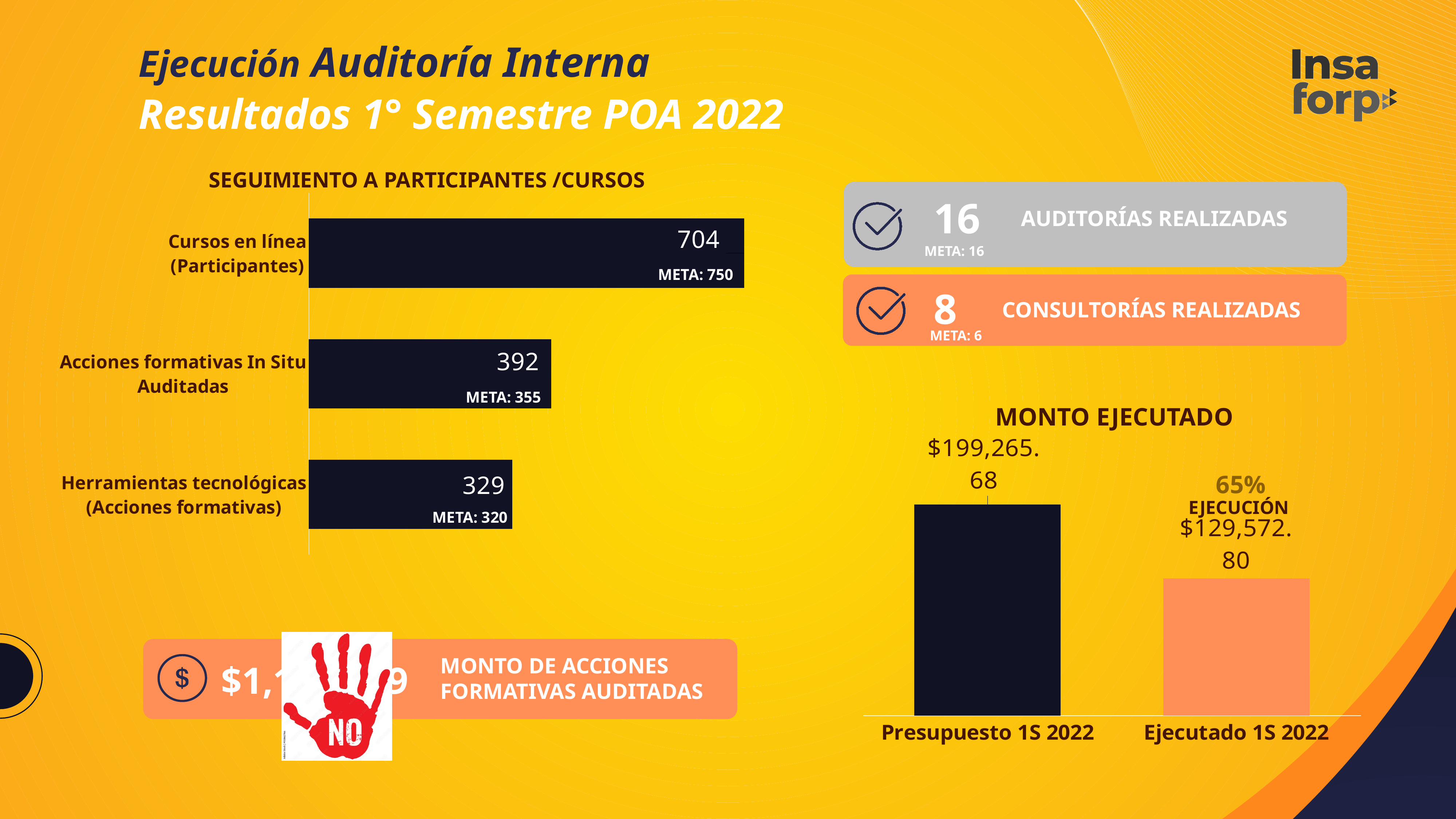
In the "SEGUIMIENTO A PARTICIPANTES /CURSOS" chart, which category has the highest value? Cursos en línea (Participantes) What kind of chart is "SEGUIMIENTO A PARTICIPANTES /CURSOS"? Bar chart In the "MONTO EJECUTADO" chart, what is the value for Presupuesto 1S 2022? $199,265.68 In the "SEGUIMIENTO A PARTICIPANTES /CURSOS" chart, which category has the lowest value? Herramientas tecnológicas (Acciones formativas) In the "MONTO EJECUTADO" chart, what is the value for Ejecutado 1S 2022? $129,572.80 In the "SEGUIMIENTO A PARTICIPANTES /CURSOS" chart, what is the value for Cursos en línea (Participantes)? 704 In the "MONTO EJECUTADO" chart, what is the difference between Presupuesto 1S 2022 and Ejecutado 1S 2022? $69,692.88 In the "MONTO EJECUTADO" chart, which is larger, Presupuesto 1S 2022 or Ejecutado 1S 2022? Presupuesto 1S 2022 In the "SEGUIMIENTO A PARTICIPANTES /CURSOS" chart, what is the value for Herramientas tecnológicas (Acciones formativas)? 329 In the "SEGUIMIENTO A PARTICIPANTES /CURSOS" chart, how many categories are shown? 3 In the "SEGUIMIENTO A PARTICIPANTES /CURSOS" chart, what is the difference between Cursos en línea (Participantes) and Acciones formativas In Situ Auditadas? 312 In the "SEGUIMIENTO A PARTICIPANTES /CURSOS" chart, what is the value for Acciones formativas In Situ Auditadas? 392